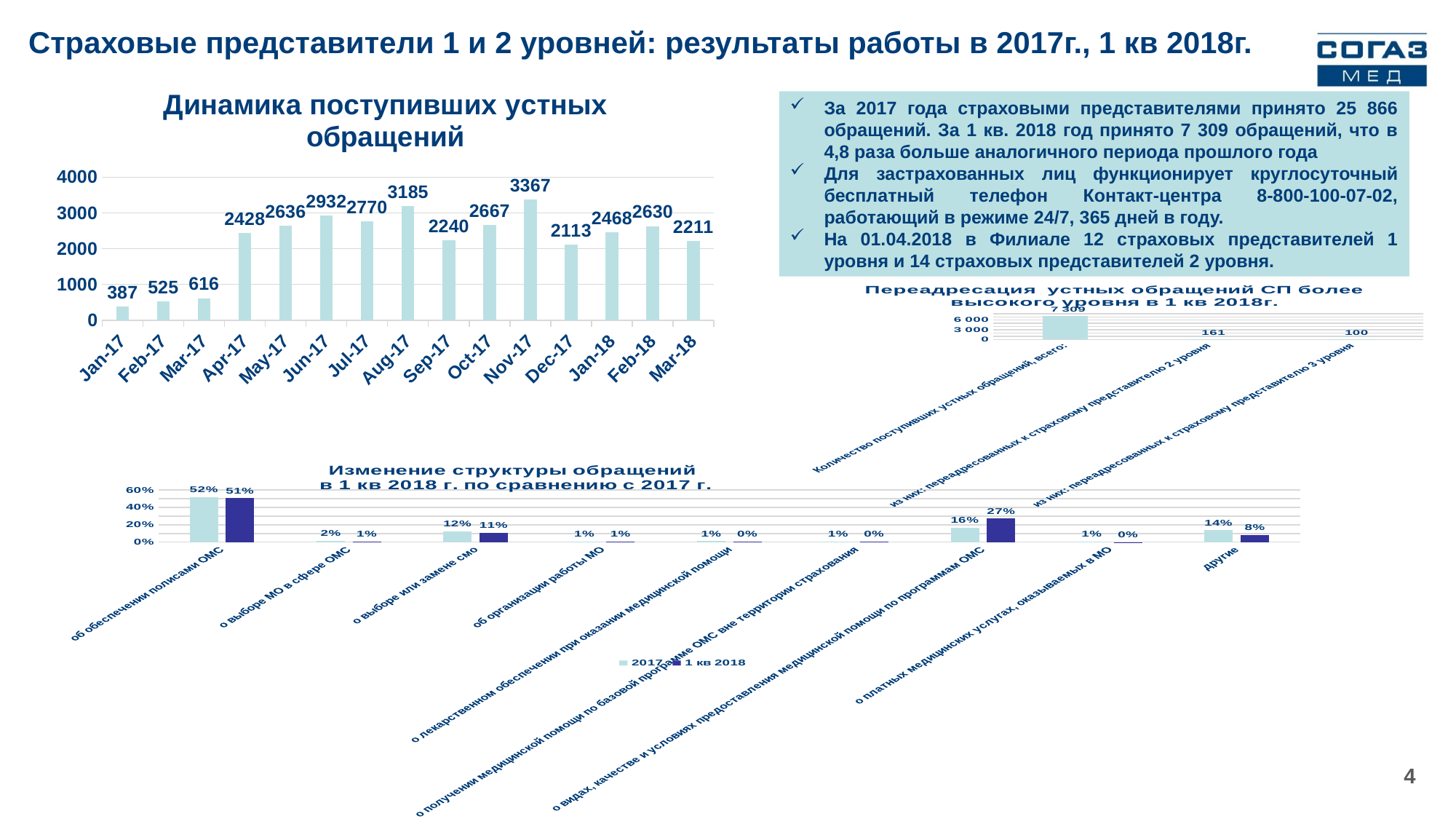
In the chart 'Динамика поступивших устных обращений', how many months are plotted? 15 In the chart 'Динамика поступивших устных обращений', which is larger: the value for Feb-18 or the value for Mar-18? Feb-18 In the chart 'Динамика поступивших устных обращений', which month has the lowest value? Jan-17 What kind of chart is 'Динамика поступивших устных обращений'? Bar chart In the chart 'Динамика поступивших устных обращений', which month has the highest value? Nov-17 In the chart 'Переадресация устных обращений СП более высокого уровня в 1 кв 2018г.', what is the value for 'из них: переадресованных к страховому представителю 2 уровня'? 161 In the chart 'Изменение структуры обращений в 1 кв 2018 г. по сравнению с 2017 г.', what is the difference between the 2017 and 1 кв 2018 values for 'другие'? 6% In the chart 'Изменение структуры обращений в 1 кв 2018 г. по сравнению с 2017 г.', how many series does the legend list? 2 In the chart 'Переадресация устных обращений СП более высокого уровня в 1 кв 2018г.', what is the total number of received oral requests ('Количество поступивших устных обращений, всего')? 7 309 In the chart 'Динамика поступивших устных обращений', what is the value for Nov-17? 3367 In the chart 'Изменение структуры обращений в 1 кв 2018 г. по сравнению с 2017 г.', what is the 1 кв 2018 value for 'о видах, качестве и условиях предоставления медицинской помощи по программам ОМС'? 27% In the chart 'Динамика поступивших устных обращений', what is the difference between the values for Aug-17 and Sep-17? 945